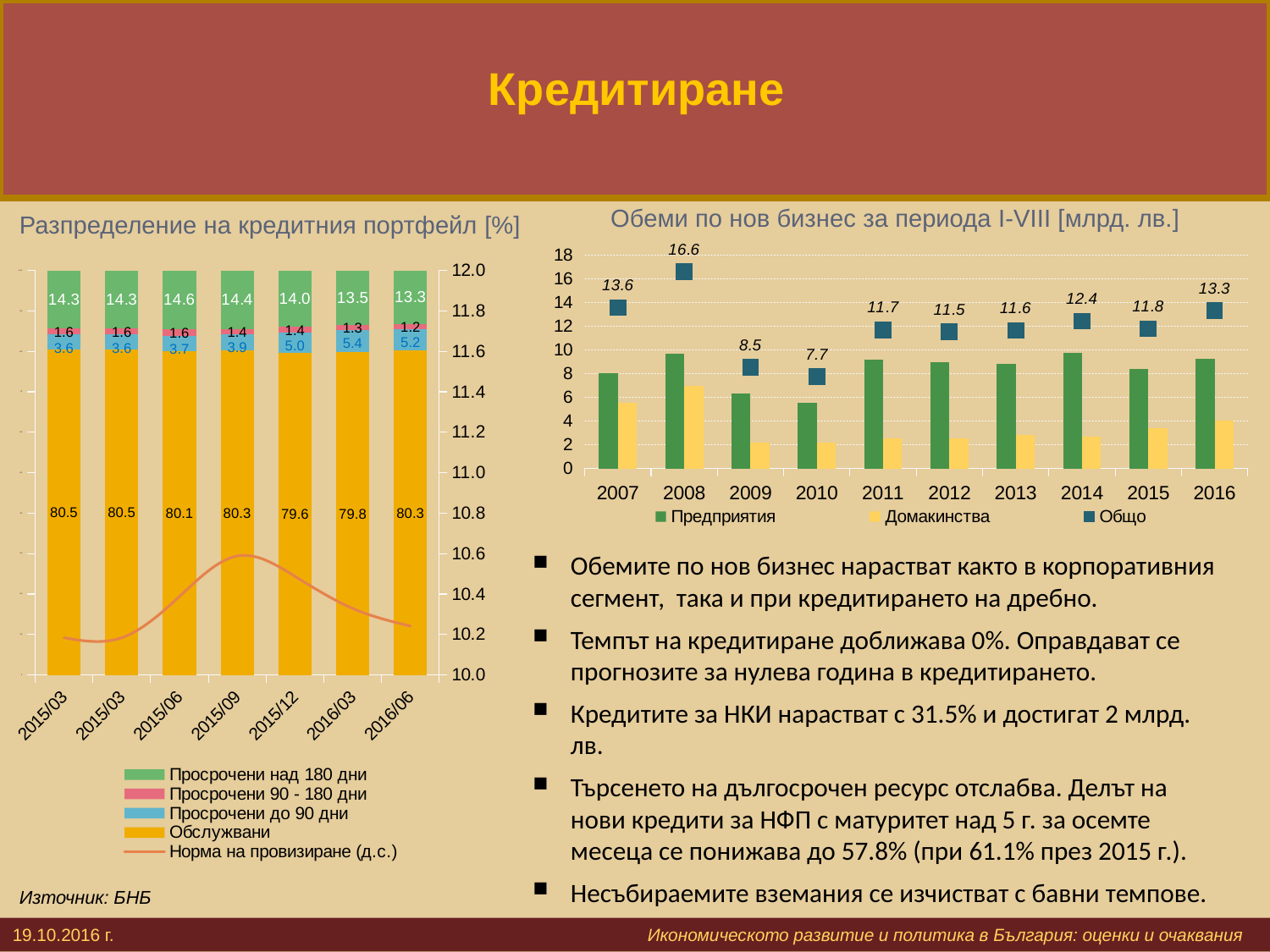
In the chart 'Обеми по нов бизнес за периода I-VIII [млрд. лв.]', is the value for Предприятия in 2008 greater or less than 8? greater In the chart 'Обеми по нов бизнес за периода I-VIII [млрд. лв.]', which year has the lowest Общо value? 2010 In the chart 'Обеми по нов бизнес за периода I-VIII [млрд. лв.]', what is the value of Общо for 2008? 16.6 What kind of chart is 'Разпределение на кредитния портфейл [%]'? Stacked bar chart with a line In the chart 'Разпределение на кредитния портфейл [%]', which is larger: Просрочени до 90 дни for 2016/03 or for 2015/06? 2016/03 In the chart 'Обеми по нов бизнес за периода I-VIII [млрд. лв.]', which year has the highest Общо value? 2008 In the chart 'Разпределение на кредитния портфейл [%]', what is the value of Обслужвани for 2015/12? 79.6 In the chart 'Обеми по нов бизнес за периода I-VIII [млрд. лв.]', what is the difference between the Общо values for 2016 and 2015? 1.5 How many series does the legend of the chart 'Обеми по нов бизнес за периода I-VIII [млрд. лв.]' list? 3 How many years are shown on the x axis of the chart 'Обеми по нов бизнес за периода I-VIII [млрд. лв.]'? 10 In the chart 'Обеми по нов бизнес за периода I-VIII [млрд. лв.]', is the value for Домакинства in 2009 greater or less than 4? less In the chart 'Разпределение на кредитния портфейл [%]', what is the value of Просрочени над 180 дни for 2016/06? 13.3